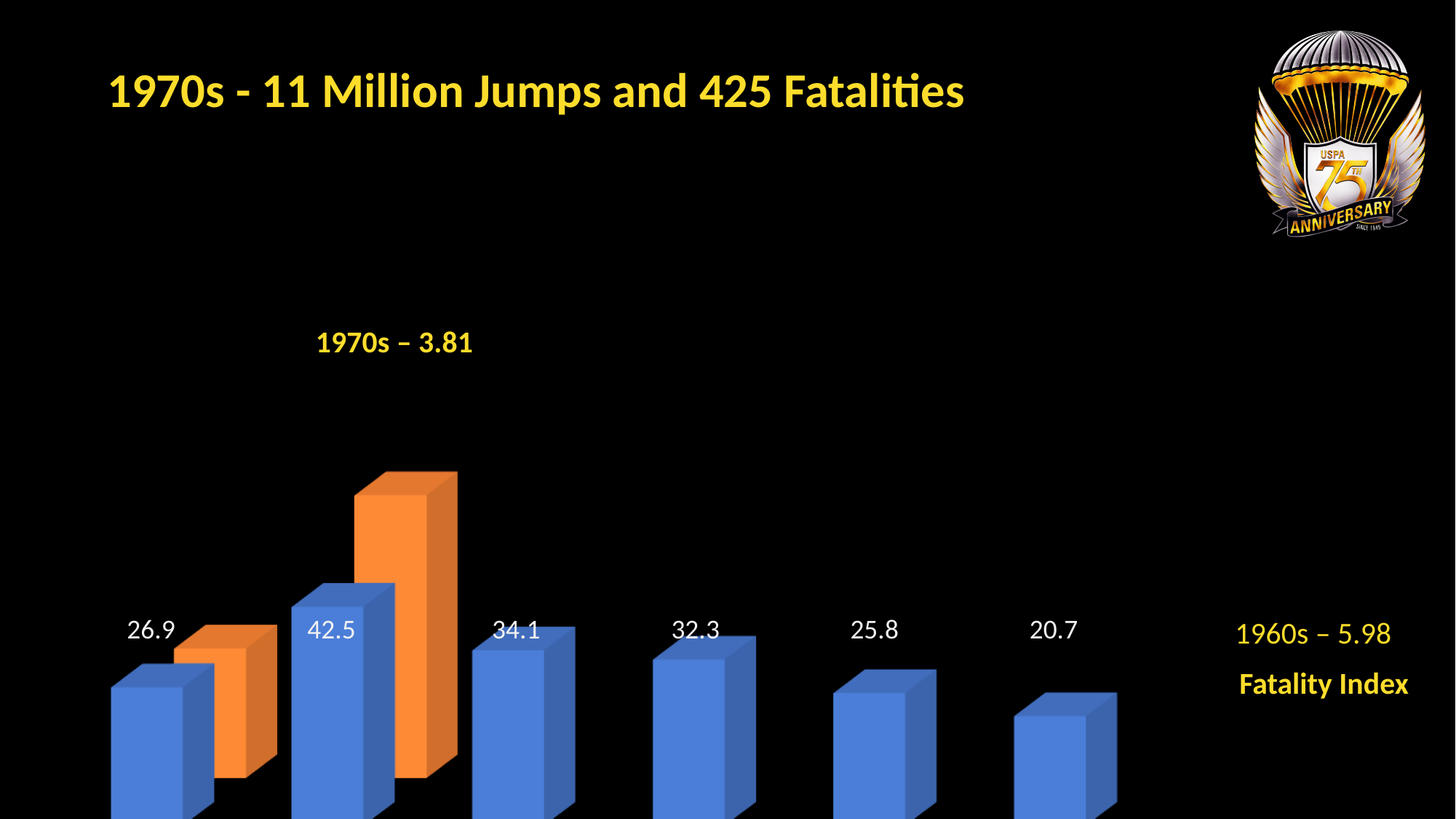
What kind of chart is shown on the slide? bar chart What is the difference between the second blue bar (42.5) and the first blue bar (26.9)? 15.6 What is the value labelled on the second blue bar from the left? 42.5 Which is larger, the third blue bar (34.1) or the fourth blue bar (32.3)? 34.1 What is the value labelled on the rightmost blue bar? 20.7 Which labelled blue bar has the lowest value? 20.7 Which labelled blue bar has the highest value? 42.5 How many blue bars have data labels on the chart? 6 Which of the two orange bars is taller, the left one or the right one? the right one How many orange bars are shown on the chart? 2 What is the value labelled on the leftmost blue bar? 26.9 Do the blue bar values rise or fall from the second bar to the sixth bar? fall